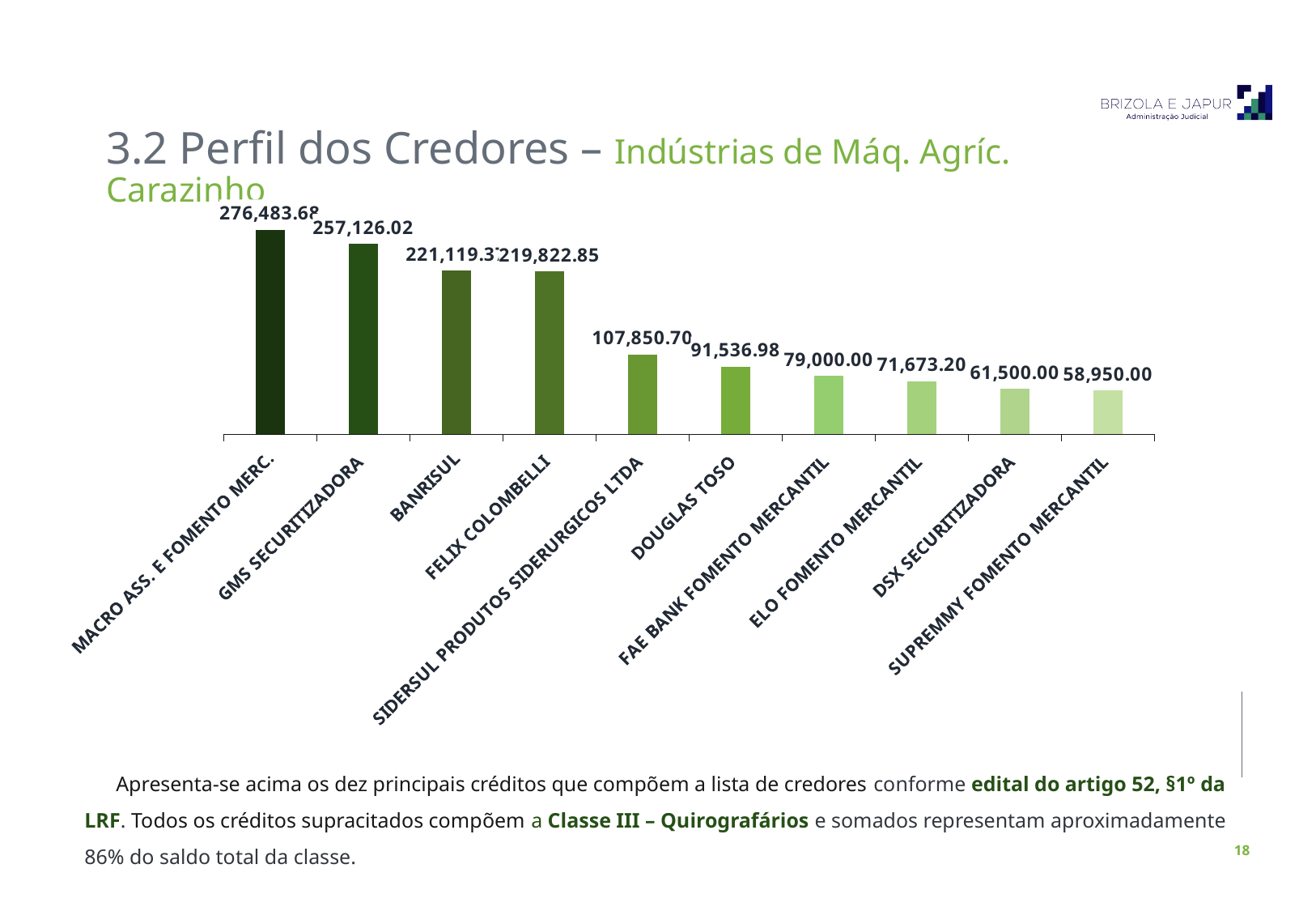
What is the value for FELIX COLOMBELLI? 219,822.85 What is the value for GMS SECURITIZADORA? 257,126.02 Which creditor has the highest value in the chart? MACRO ASS. E FOMENTO MERC. Which creditor has the lowest value in the chart? SUPREMMY FOMENTO MERCANTIL Which is larger, the value for SIDERSUL PRODUTOS SIDERURGICOS LTDA or the value for DOUGLAS TOSO? SIDERSUL PRODUTOS SIDERURGICOS LTDA Do the values rise or fall from left to right across the chart? fall What kind of chart is shown on the slide? bar chart How many creditors are shown in the chart? 10 What is the difference between the values for FAE BANK FOMENTO MERCANTIL and ELO FOMENTO MERCANTIL? 7,326.80 What is the value for SIDERSUL PRODUTOS SIDERURGICOS LTDA? 107,850.70 What is the value for DSX SECURITIZADORA? 61,500.00 What is the value for DOUGLAS TOSO? 91,536.98